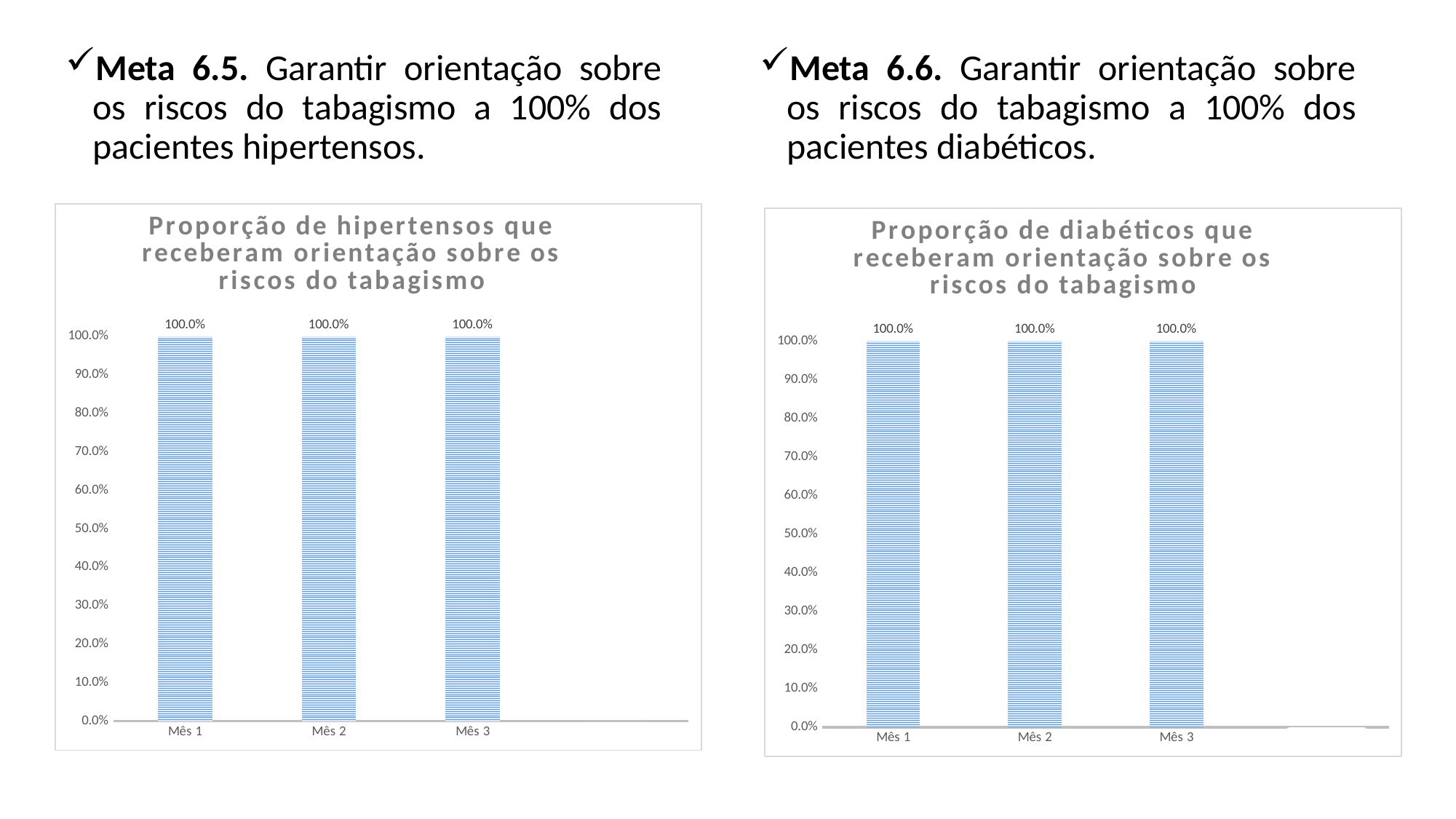
How many categories are shown on the x axis of the left chart (Proporção de hipertensos que receberam orientação sobre os riscos do tabagismo)? 3 In the right chart (Proporção de diabéticos que receberam orientação sobre os riscos do tabagismo), what is the value for Mês 3? 100.0% In the left chart (Proporção de hipertensos que receberam orientação sobre os riscos do tabagismo), what is the value for Mês 3? 100.0% In the left chart (Proporção de hipertensos que receberam orientação sobre os riscos do tabagismo), what is the difference between the values for Mês 1 and Mês 2? 0.0% In the left chart (Proporção de hipertensos que receberam orientação sobre os riscos do tabagismo), what is the value for Mês 1? 100.0% In the right chart (Proporção de diabéticos que receberam orientação sobre os riscos do tabagismo), what is the value for Mês 2? 100.0% In the left chart (Proporção de hipertensos que receberam orientação sobre os riscos do tabagismo), is the value for Mês 2 greater or less than 50.0%? greater How many bars are plotted in the right chart (Proporção de diabéticos que receberam orientação sobre os riscos do tabagismo)? 3 In the right chart (Proporção de diabéticos que receberam orientação sobre os riscos do tabagismo), what is the difference between the values for Mês 3 and Mês 1? 0.0% What kind of chart is the left chart (Proporção de hipertensos que receberam orientação sobre os riscos do tabagismo)? Bar chart What is the title of the right chart on the slide? Proporção de diabéticos que receberam orientação sobre os riscos do tabagismo Do the values in the right chart (Proporção de diabéticos que receberam orientação sobre os riscos do tabagismo) rise, fall or stay the same from Mês 1 to Mês 3? Stay the same